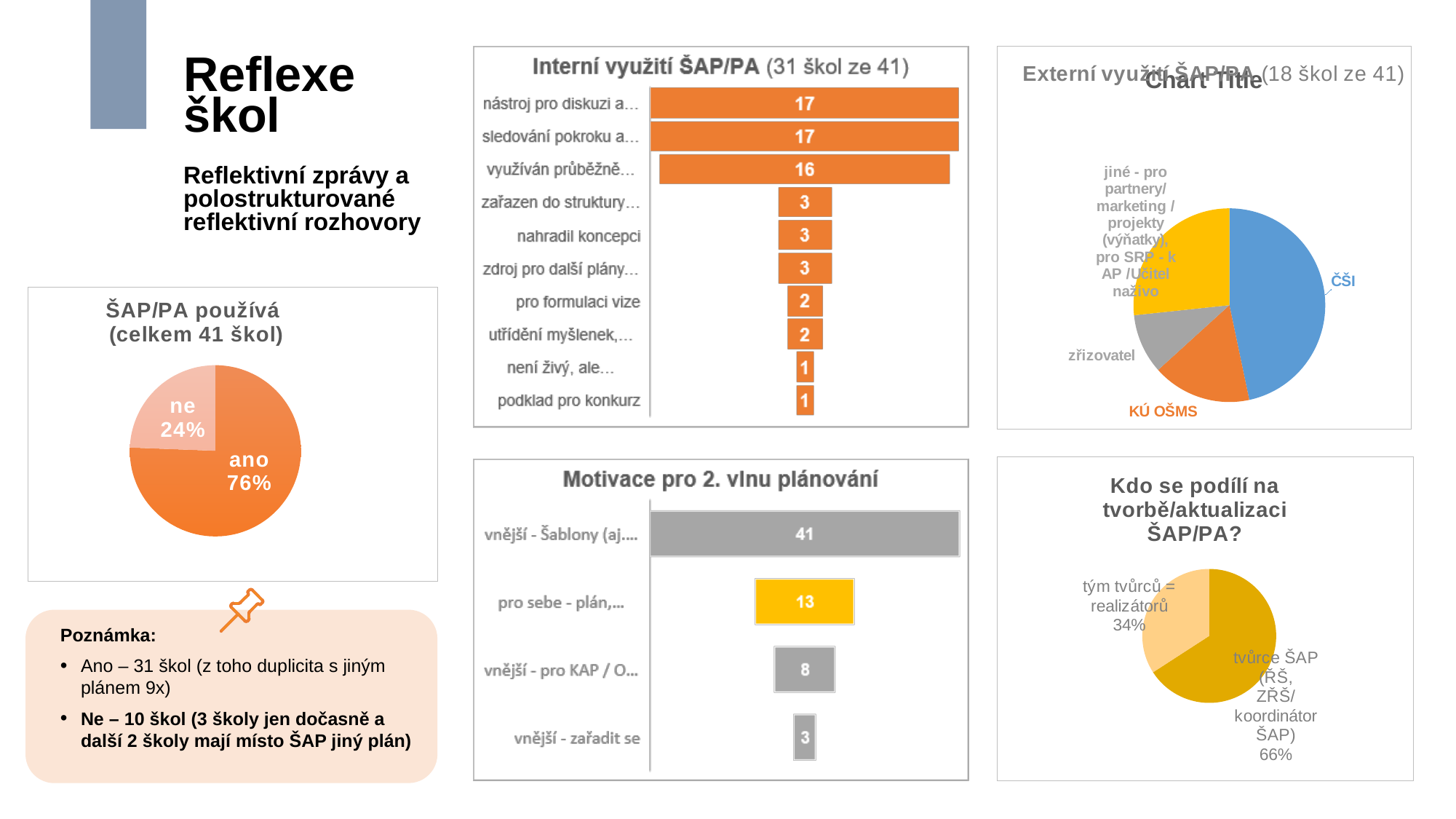
In the chart 'ŠAP/PA používá (celkem 41 škol)', what share of the pie is 'ne'? 24% In the chart 'Interní využití ŠAP/PA', what is the value for 'nahradil koncepci'? 3 In the chart 'Externí využití ŠAP/PA (18 škol ze 41)', which slice is the largest? ČŠI In the chart 'Interní využití ŠAP/PA', what is the value for 'pro formulaci vize'? 2 In the chart 'Kdo se podílí na tvorbě/aktualizaci ŠAP/PA?', what share of the pie is 'tým tvůrců = realizátorů'? 34% In the chart 'Motivace pro 2. vlnu plánování', what is the difference between the values for 'vnější - Šablony (aj....' and 'vnější - pro KAP / O...'? 33 In the chart 'Motivace pro 2. vlnu plánování', which category has the highest value? vnější - Šablony (aj.... In the chart 'Interní využití ŠAP/PA', what is the value for 'podklad pro konkurz'? 1 In the chart 'Interní využití ŠAP/PA', what kind of chart is shown? bar chart In the chart 'Motivace pro 2. vlnu plánování', what is the value for 'pro sebe - plán,...'? 13 In the chart 'Interní využití ŠAP/PA', how many categories are plotted? 10 In the chart 'ŠAP/PA používá (celkem 41 škol)', what share of the pie is 'ano'? 76%